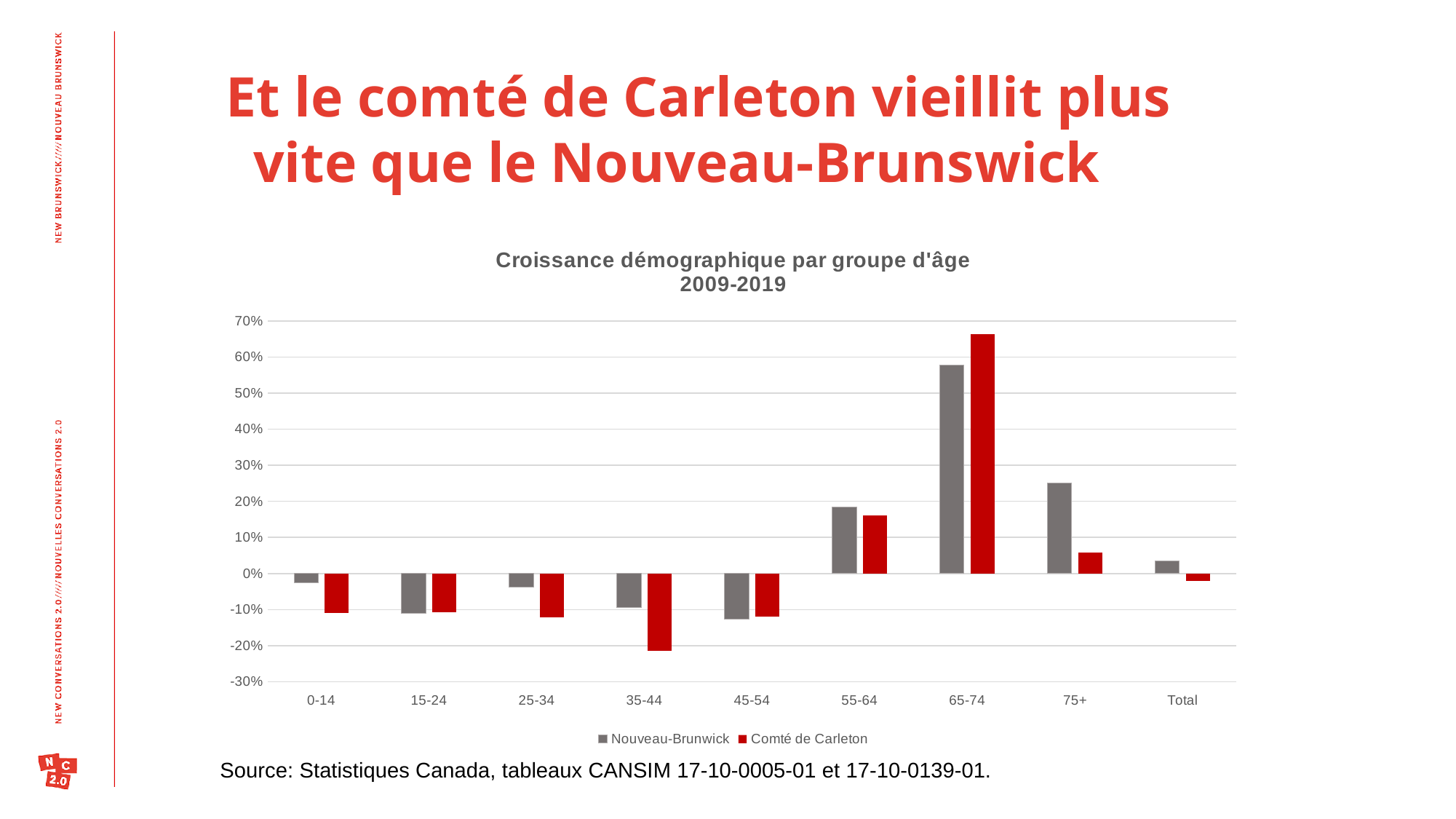
Is the value for Comté de Carleton in the 65-74 group greater or less than 60%? greater Which age group has the lowest value for Comté de Carleton? 35-44 Which age group has the highest value for Comté de Carleton? 65-74 For the 75+ group, which series has the larger value, Nouveau-Brunswick or Comté de Carleton? Nouveau-Brunswick Is the value for Nouveau-Brunswick in the 65-74 group greater or less than 50%? greater For the 65-74 group, which series has the larger value, Nouveau-Brunswick or Comté de Carleton? Comté de Carleton Is the value for Comté de Carleton in the 35-44 group greater or less than -20%? less Which age group has the highest value for Nouveau-Brunswick? 65-74 How many categories are shown along the x axis? 9 What is the title of the chart? Croissance démographique par groupe d'âge 2009-2019 How many series does the legend list? 2 What kind of chart is shown on the slide? bar chart